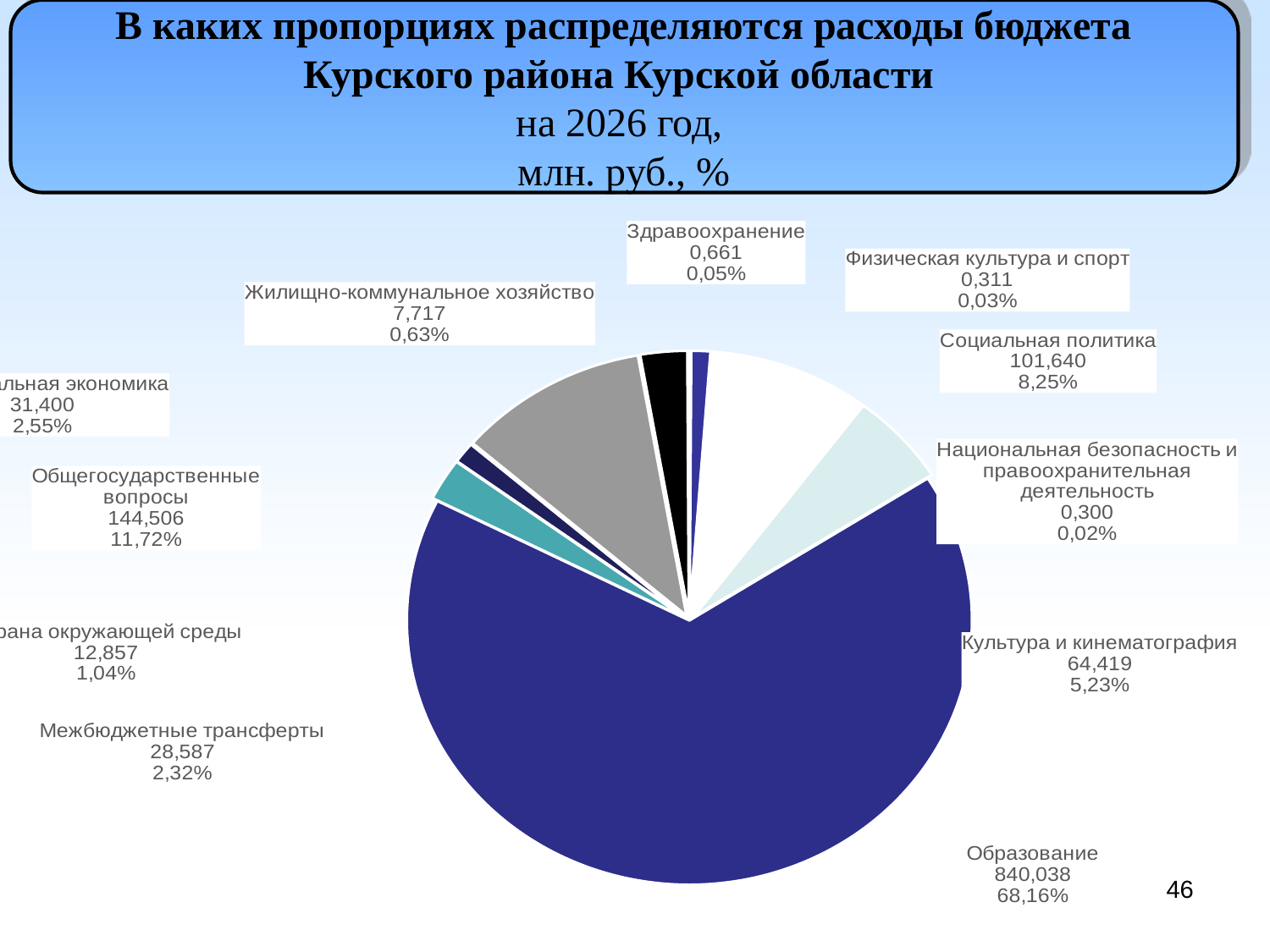
What share of the pie does Общегосударственные вопросы represent? 11,72% What share of the pie does Образование represent? 68,16% Which is larger, Социальная политика or Культура и кинематография? Социальная политика What share of the pie does Жилищно-коммунальное хозяйство represent? 0,63% What is the value for Культура и кинематография? 64,419 What is the value for Социальная политика? 101,640 Which category has the largest share of the pie? Образование What type of chart is shown on the slide? pie chart What is the difference in percentage share between Социальная политика and Культура и кинематография? 3,02% Which category has the smallest share of the pie? Национальная безопасность и правоохранительная деятельность What is the value for Межбюджетные трансферты? 28,587 What is the value for Образование? 840,038